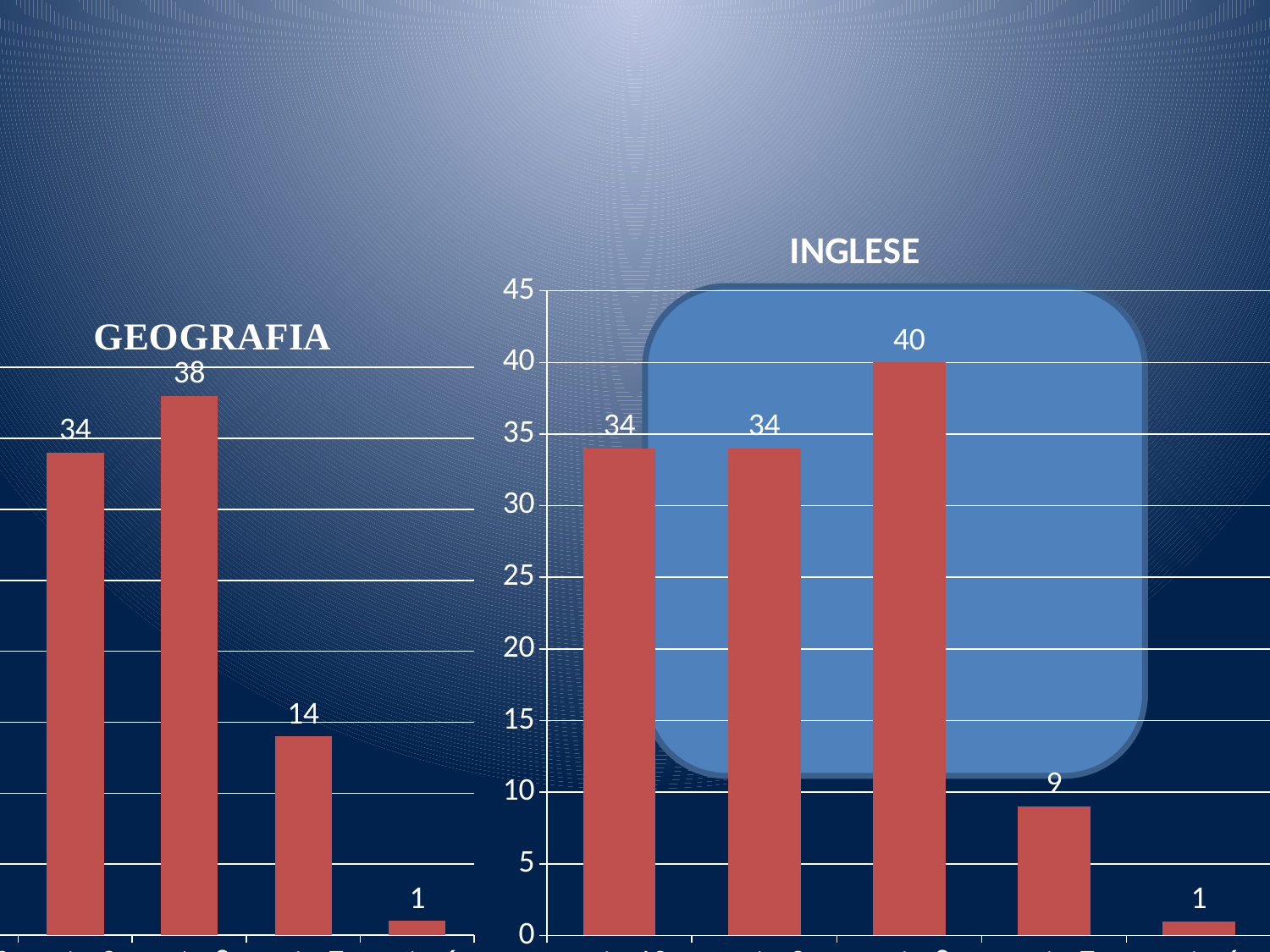
In the INGLESE chart on the right, what is the highest value shown? 40 In the INGLESE chart on the right, what is the difference between the tallest bar (40) and the first bar (34)? 6 In the GEOGRAFIA chart on the left, what is the value of the third bar from the left? 14 In the GEOGRAFIA chart on the left, what is the difference between the second bar (38) and the first bar (34)? 4 In the GEOGRAFIA chart on the left, what is the highest value shown? 38 What kind of chart is the GEOGRAFIA chart on the left? bar chart How many bars are plotted in the GEOGRAFIA chart on the left? 4 Which is larger: the third bar in the GEOGRAFIA chart (14) or the fourth bar in the INGLESE chart (9)? the third bar in the GEOGRAFIA chart (14) In the INGLESE chart on the right, what is the lowest value shown? 1 In the INGLESE chart on the right, what is the value of the fourth bar from the left? 9 How many bars are plotted in the INGLESE chart on the right? 5 What is the title of the chart on the right side of the slide? INGLESE